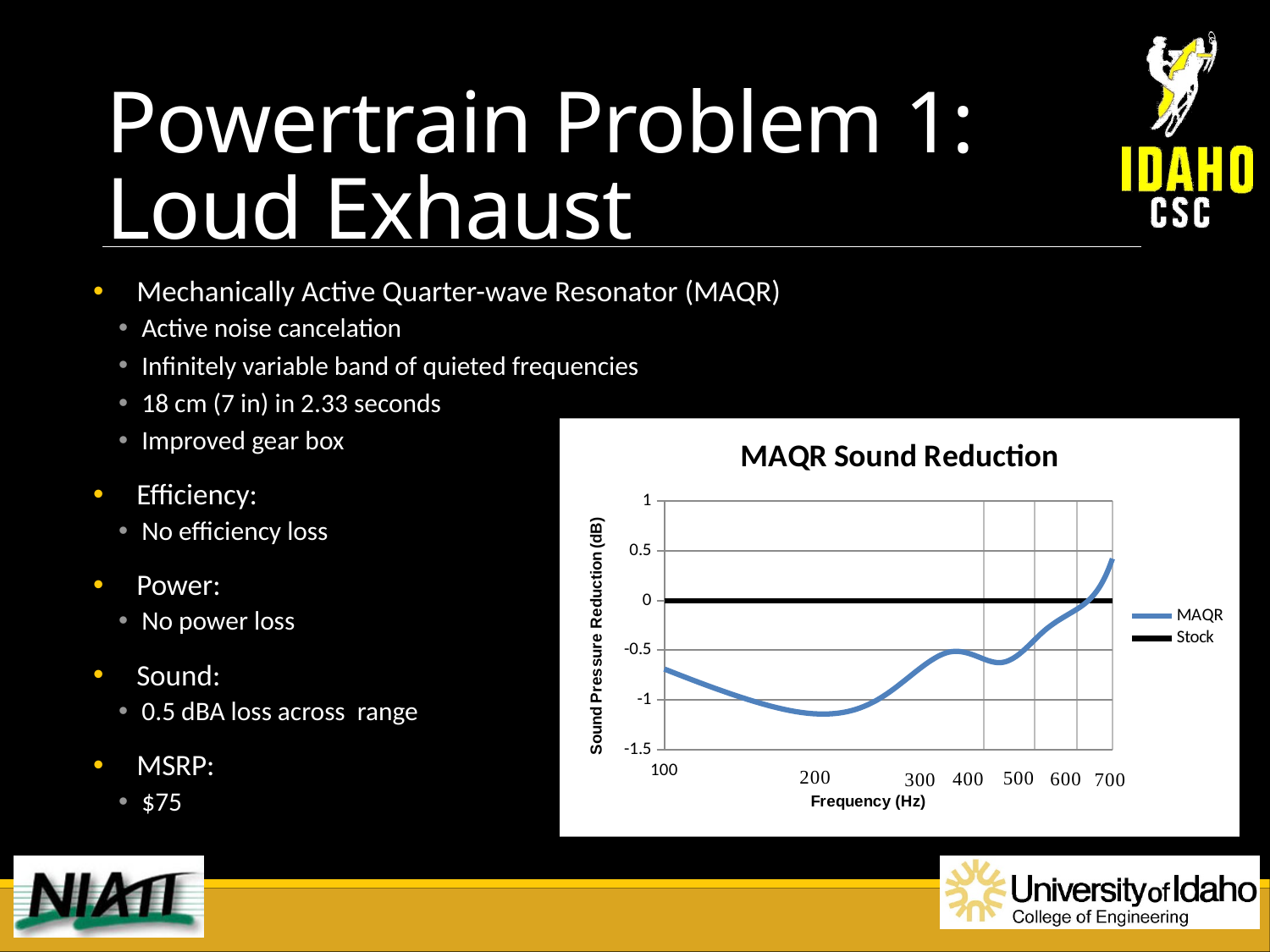
Is the MAQR value at 400 Hz greater or less than -1? greater What is the title of the chart on the slide? MAQR Sound Reduction What kind of chart is shown on the slide? line chart How many series does the legend of the MAQR Sound Reduction chart list? 2 Is the MAQR value at 700 Hz greater or less than 0? greater Does the MAQR series rise or fall between 300 Hz and 700 Hz overall? rise How many frequency tick labels are shown on the x axis of the chart? 7 What value does the Stock series hold across the frequency range in the chart? 0 What is the label of the y axis of the chart? Sound Pressure Reduction (dB) Is the MAQR value at 100 Hz greater or less than -0.5? less At 200 Hz, which series has the larger value, MAQR or Stock? Stock